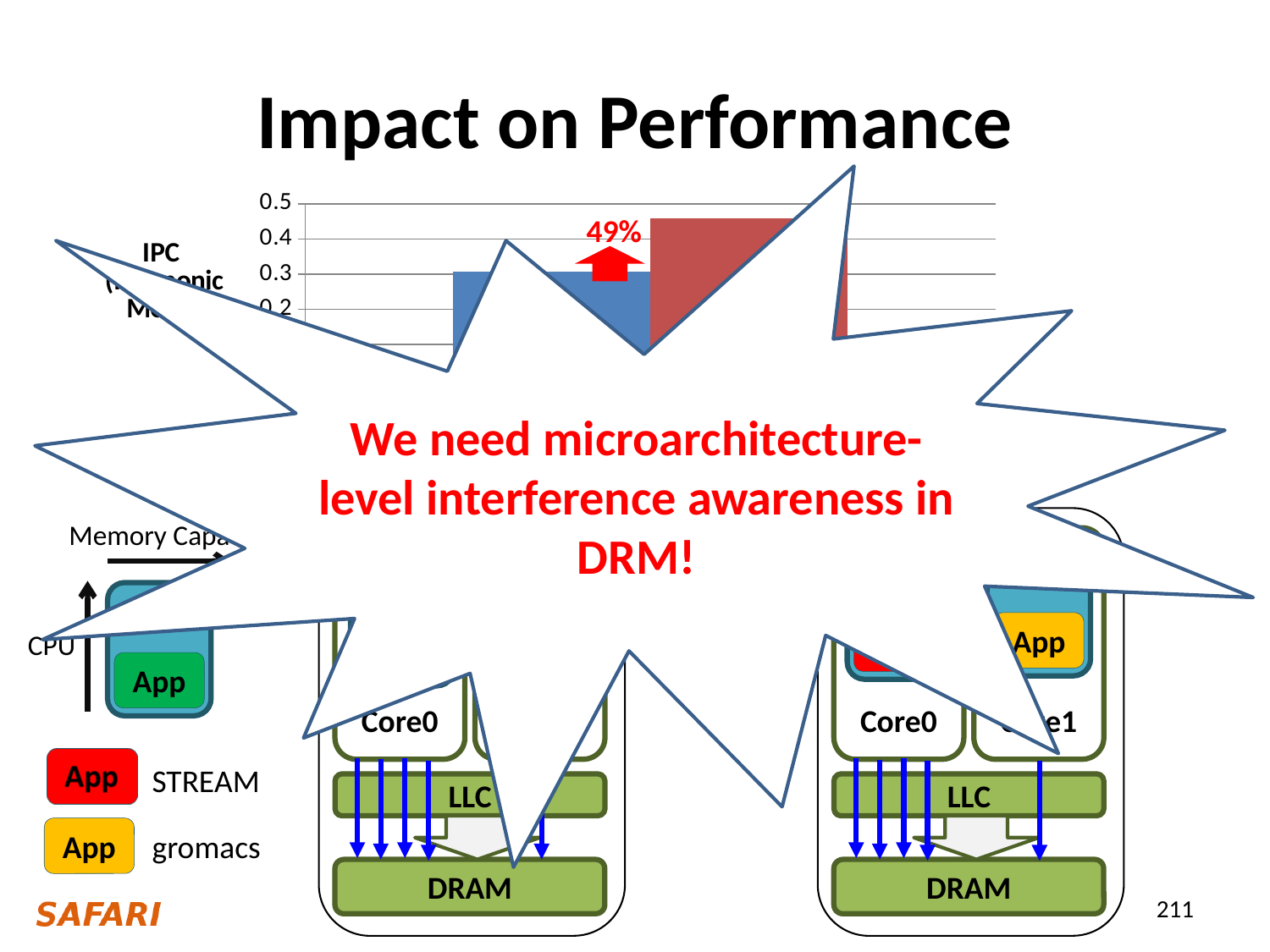
What is the highest value shown on the chart's vertical axis? 0.5 Which bar is taller in the chart, the blue bar or the red bar? the red bar What kind of chart is shown on the slide? bar chart Is the value of the red bar greater or less than 0.4? greater What percentage is printed in red above the bars in the chart? 49% Is the value of the red bar greater or less than 0.3? greater Is the value of the blue bar greater or less than 0.4? less